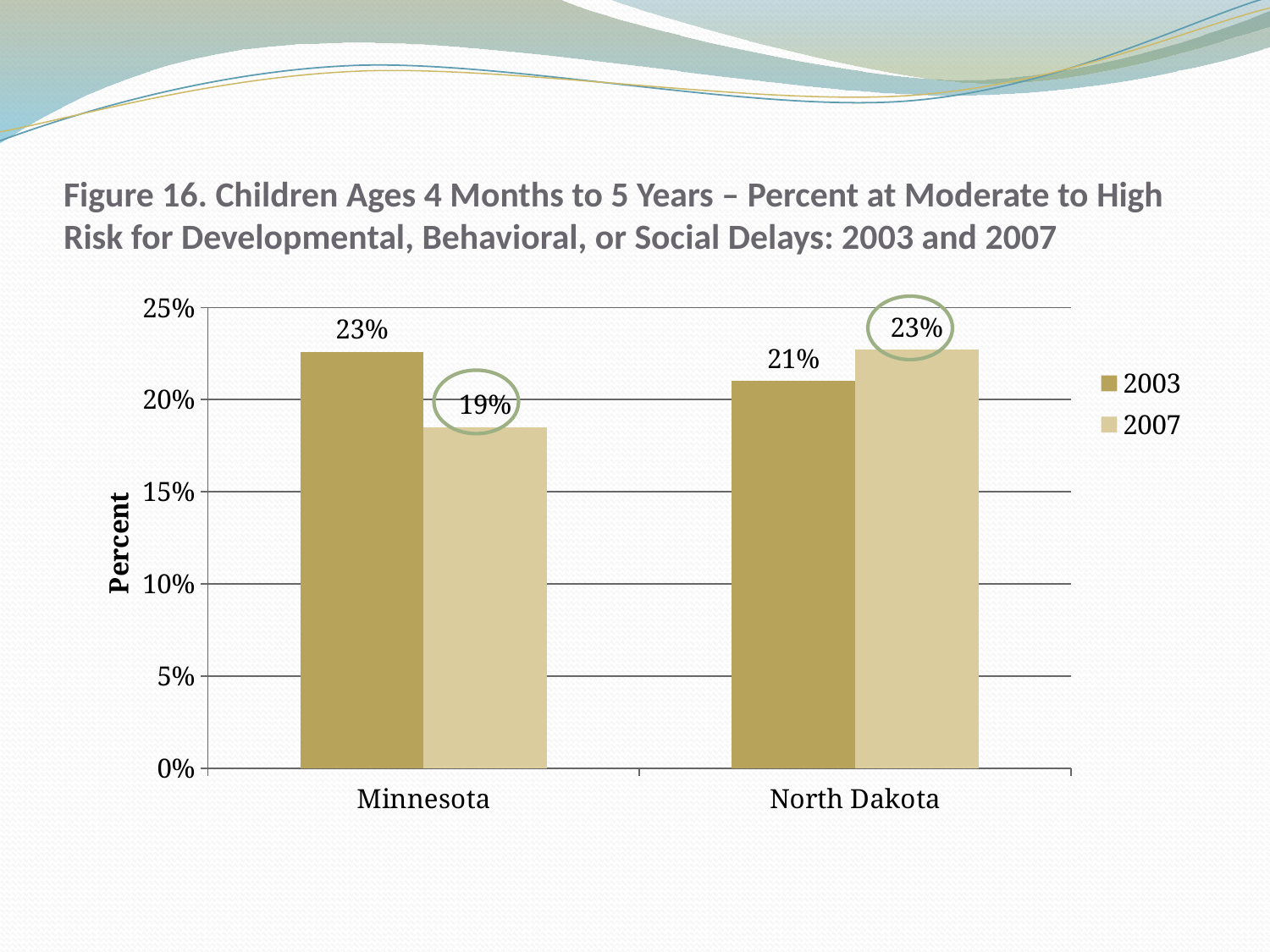
What was the percent for Minnesota in 2003? 23% Is the 2007 value for Minnesota greater or less than 20%? less What was the percent for North Dakota in 2003? 21% What is the difference in percentage points between North Dakota's 2007 and 2003 values? 2 What is the difference in percentage points between Minnesota's 2003 and 2007 values? 4 What is the label on the vertical axis? Percent What was the percent for Minnesota in 2007? 19% What was the percent for North Dakota in 2007? 23% How many series does the legend list? 2 Which state had the higher percent in 2003? Minnesota Which state had the lower percent in 2007? Minnesota What kind of chart is shown on the slide? Bar chart